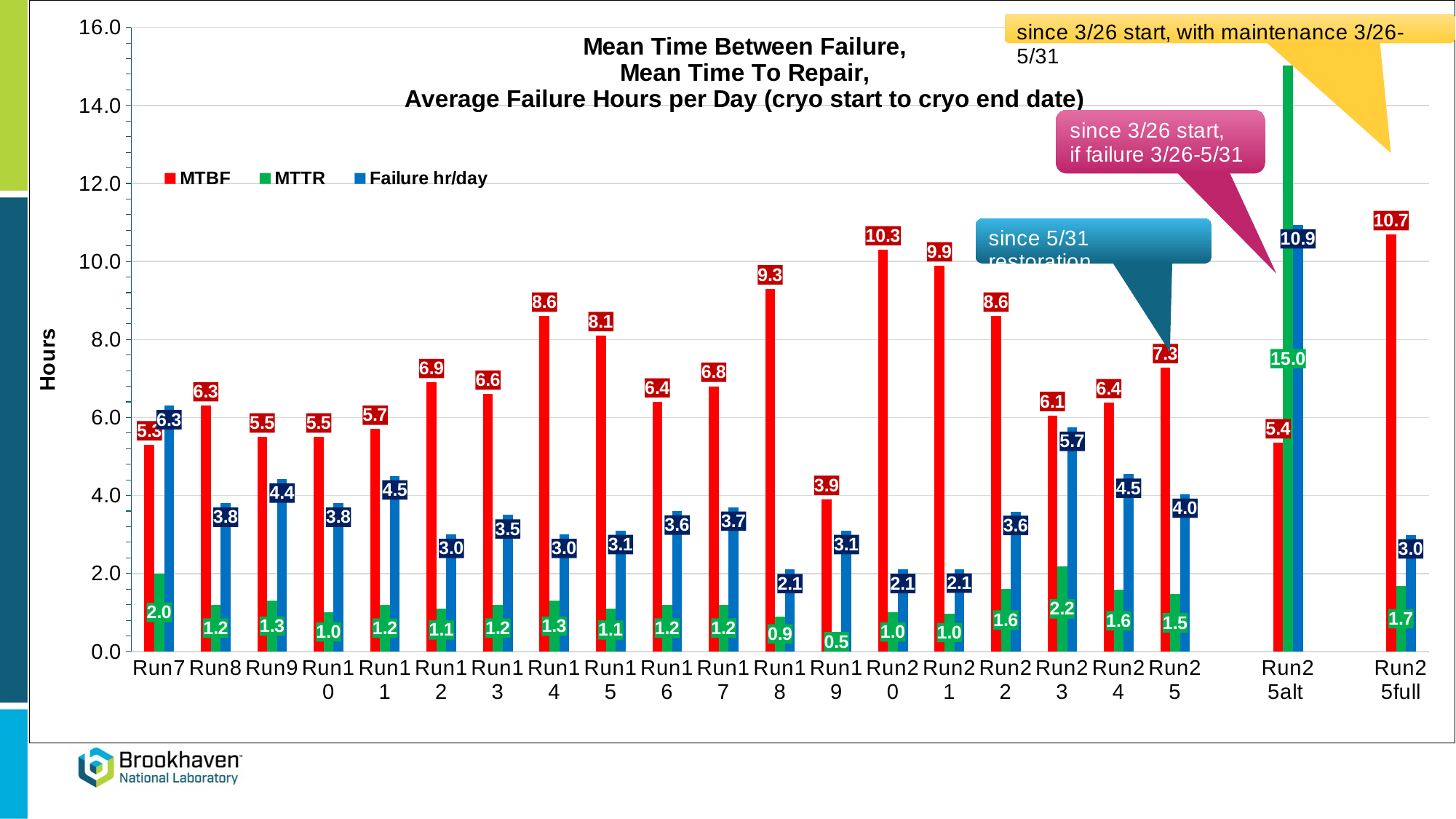
Which run has the lowest MTTR? Run19 What is the MTBF value for Run20? 10.3 Which run has the highest MTBF? Run25full What kind of chart is shown on the slide? Bar chart Which is larger, the Failure hr/day for Run7 or for Run8? Run7 What is the MTTR value for Run25alt? 15.0 How many runs (categories) are shown on the x axis? 21 What is the label of the y axis? Hours What is the Failure hr/day value for Run23? 5.7 Which run has the lowest MTBF? Run19 How many series does the legend list? 3 What is the difference between the MTBF of Run25full and the MTBF of Run25alt? 5.3